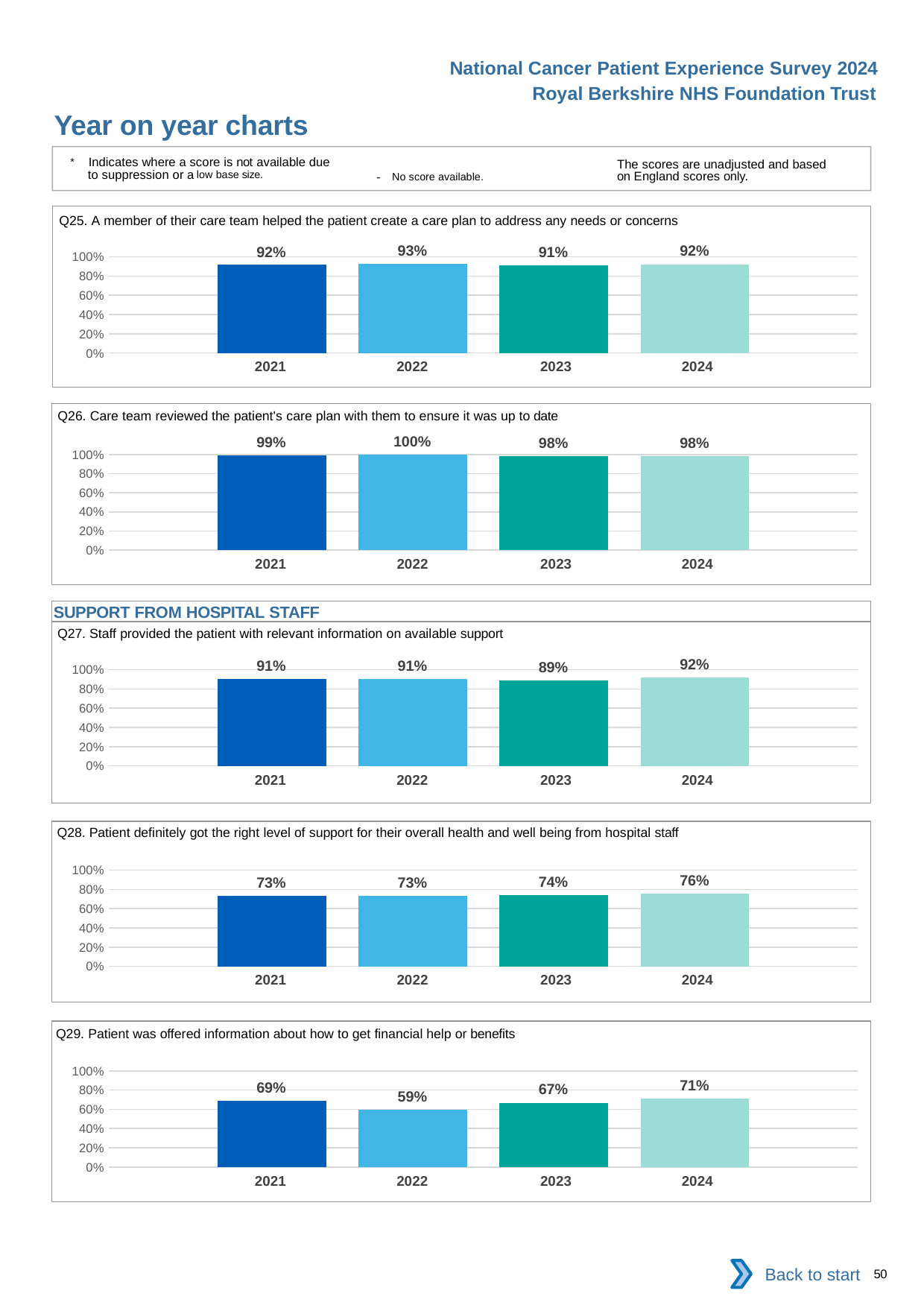
In the Q26 chart, what is the value for 2024? 98% How many years are shown in the Q25 chart? 4 In the Q27 chart, which year has the lowest value? 2023 What kind of chart is the Q28 chart? bar chart In the Q29 chart, is the value for 2021 larger or smaller than the value for 2023? larger In the Q28 chart, do the values rise or fall from 2022 to 2024? rise In the Q29 chart, what is the difference between the 2024 value and the 2022 value? 12% In the Q25 chart, what is the value for 2022? 93% In the Q29 chart, which year has the lowest value? 2022 In the Q28 chart, what is the value for 2024? 76% In the Q26 chart, which year has the highest value? 2022 In the Q27 chart, what is the difference between the 2024 value and the 2023 value? 3%